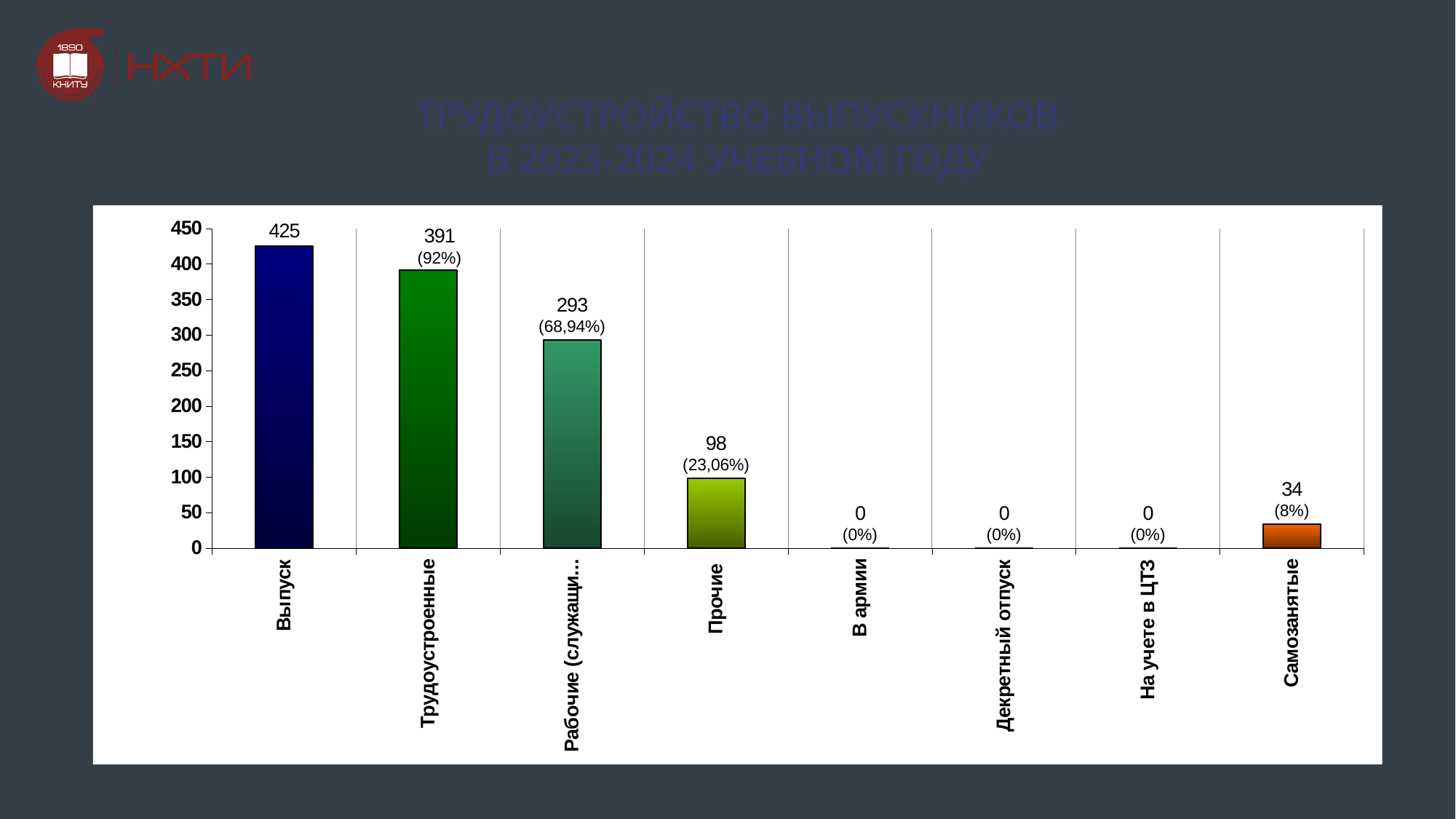
What is the value for Выпуск? 425 What is the value for Прочие? 98 What is the value for В армии? 0 What is the difference between the values for Выпуск and Трудоустроенные? 34 What percentage is shown for Самозанятые? 8% Which is larger, the value for Прочие or the value for Самозанятые? Прочие How many categories are shown on the x axis? 8 Which category has the highest value? Выпуск What is the value for Трудоустроенные? 391 What percentage is shown for Трудоустроенные? 92% What is the value for Самозанятые? 34 What kind of chart is this? bar chart